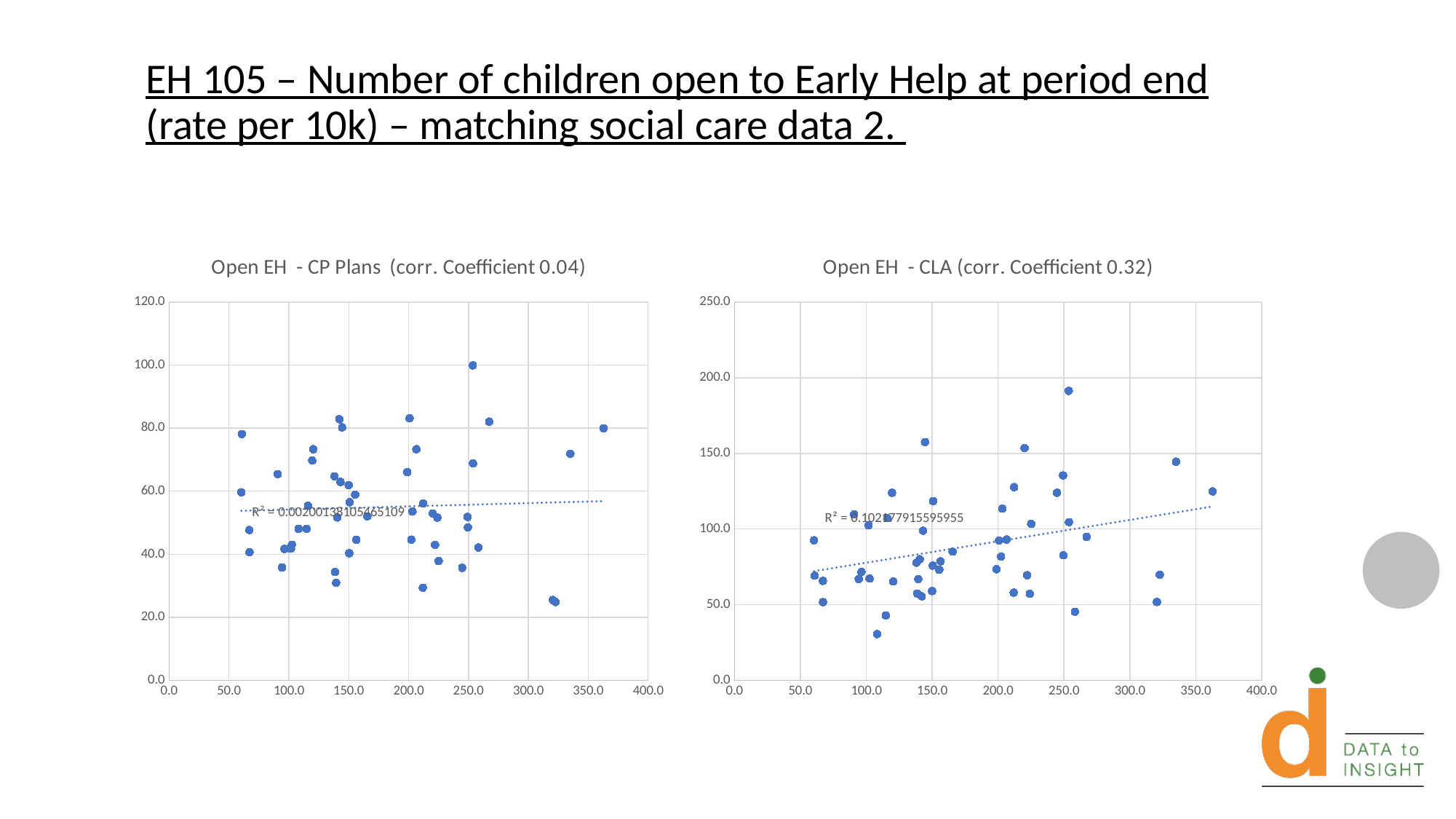
In the right chart 'Open EH - CLA', does the dotted trend line rise or fall as the x value increases? rises What kind of chart is the left chart titled 'Open EH - CP Plans'? scatter chart Which chart reports the higher correlation coefficient in its title, 'Open EH - CP Plans' or 'Open EH - CLA'? Open EH - CLA In the left chart 'Open EH - CP Plans', is the y value of the highest point greater or less than 80.0? greater What is the difference between the correlation coefficients stated in the titles of the right chart (Open EH - CLA) and the left chart (Open EH - CP Plans)? 0.28 In the right chart 'Open EH - CLA', what correlation coefficient is stated in the title? 0.32 In the left chart 'Open EH - CP Plans', what correlation coefficient is stated in the title? 0.04 In the right chart 'Open EH - CLA', what is the maximum value shown on the y axis? 250.0 In the left chart 'Open EH - CP Plans', what is the maximum value shown on the y axis? 120.0 In the right chart 'Open EH - CLA', is the y value of the lowest point greater or less than 50.0? less What kind of chart is the right chart titled 'Open EH - CLA'? scatter chart In the right chart 'Open EH - CLA', is the y value of the highest point greater or less than 150.0? greater